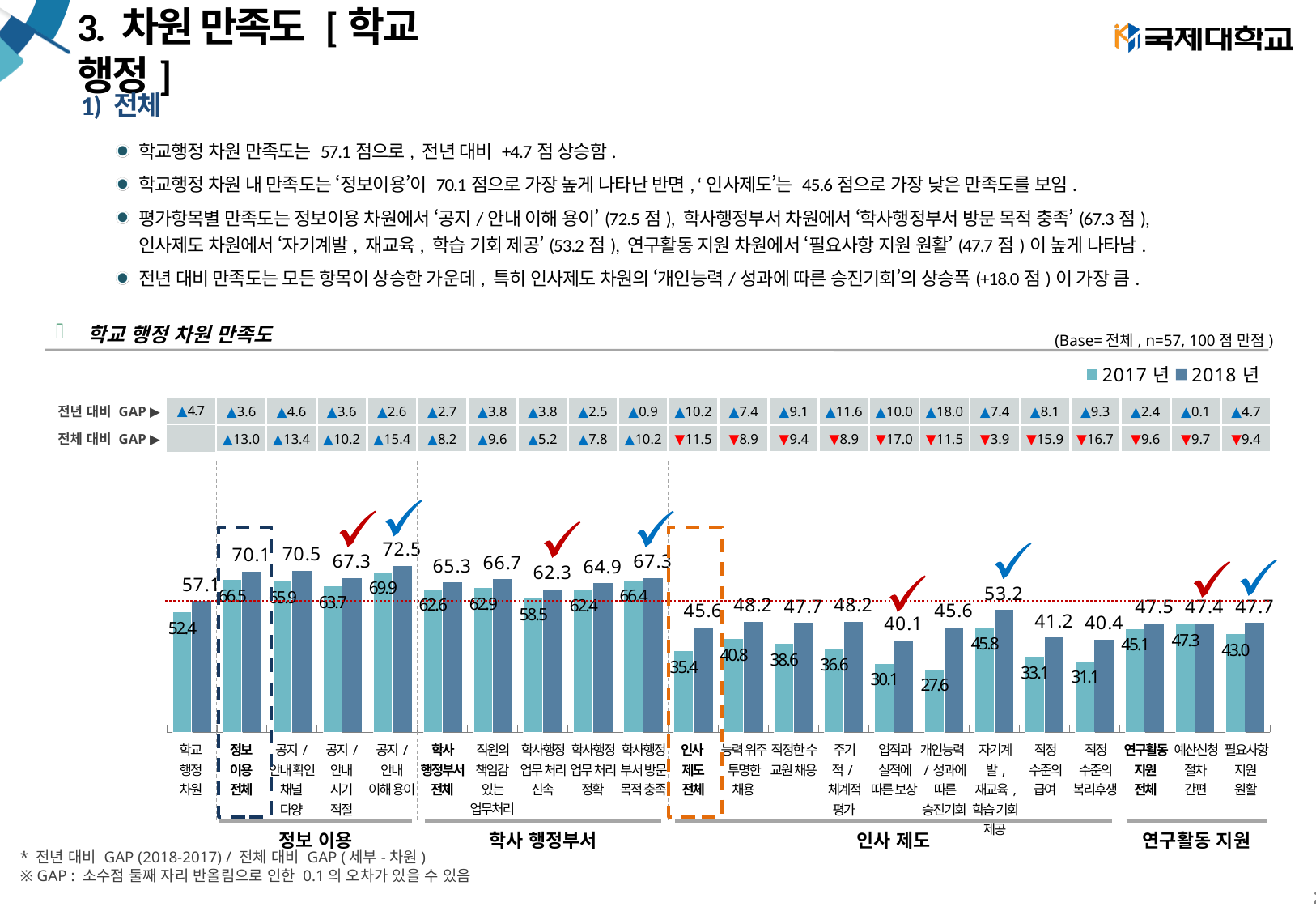
What is the title of the chart? 학교 행정 차원 만족도 What is the difference between the 2018년 and 2017년 values for 인사 제도 전체? 10.2 Which is larger, the 2018년 value for 정보 이용 전체 or the 2018년 value for 학사 행정부서 전체? 정보 이용 전체 Which category has the lowest 2017년 value? 개인능력/성과에 따른 승진기회 Which category has the highest 2018년 value? 공지/안내 이해용이 What kind of chart is shown on the slide? bar chart What is the 2018년 value for 학교 행정 차원? 57.1 What is the 2018년 value for 자기계발, 재교육, 학습 기회 제공? 53.2 How many categories are shown on the x axis of the chart? 22 Which category has the lowest 2018년 value? 업적과 실적에 따른 보상 What is the 2017년 value for 인사 제도 전체? 35.4 How many series does the legend list? 2